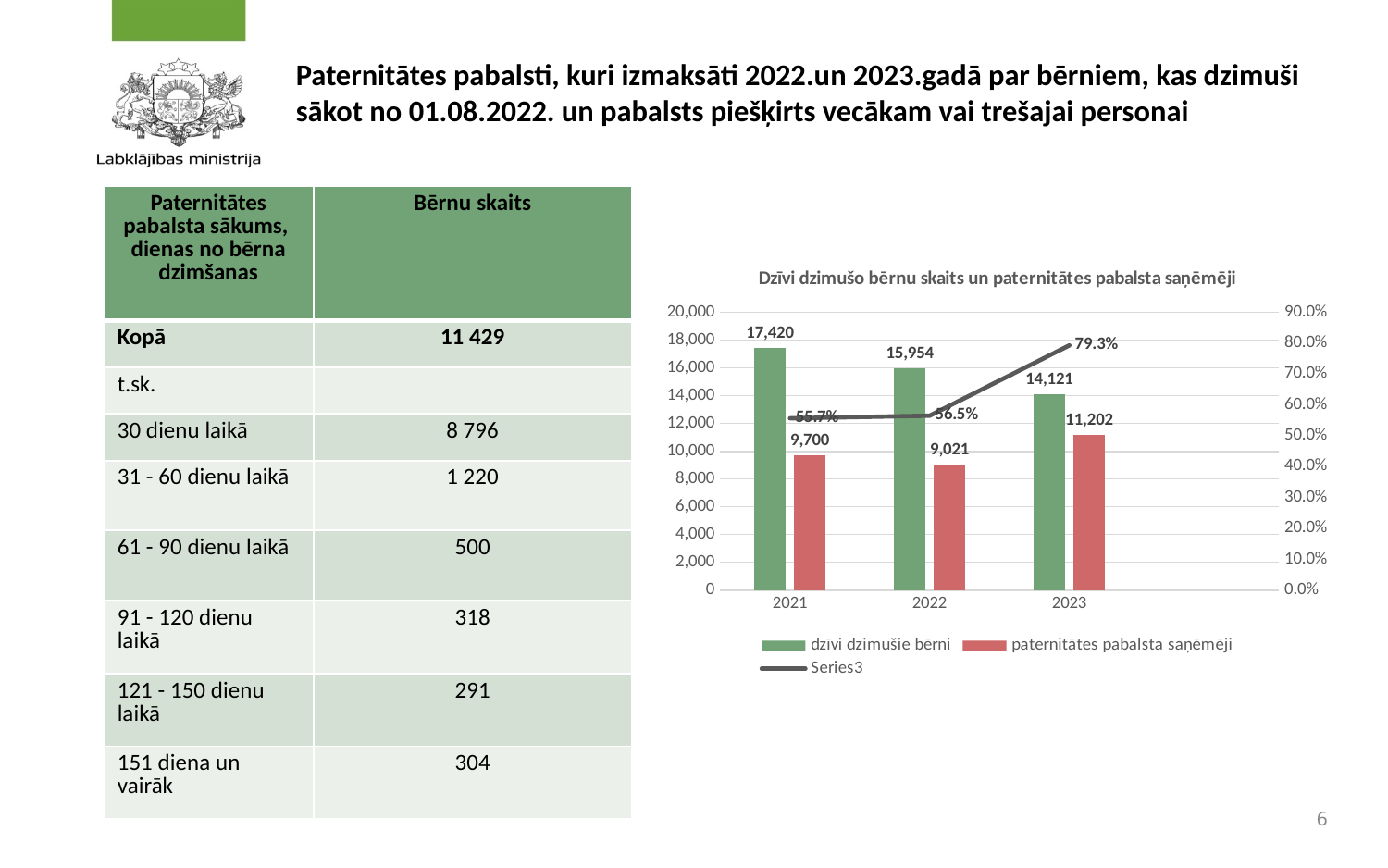
What is the value for dzīvi dzimušie bērni in 2021? 17,420 Does the value for dzīvi dzimušie bērni rise or fall from 2021 to 2023? fall What is the difference between dzīvi dzimušie bērni and paternitātes pabalsta saņēmēji in 2022? 6,933 What is the value for paternitātes pabalsta saņēmēji in 2023? 11,202 In which year is the value for dzīvi dzimušie bērni the lowest? 2023 Which is larger in 2021: dzīvi dzimušie bērni or paternitātes pabalsta saņēmēji? dzīvi dzimušie bērni In which year is the value for paternitātes pabalsta saņēmēji the highest? 2023 What type of chart is shown on the slide? Bar chart with a line How many years are shown on the x axis of the chart? 3 How many series does the chart legend list? 3 What is the title of the chart on the slide? Dzīvi dzimušo bērnu skaits un paternitātes pabalsta saņēmēji What is the Series3 value for 2023? 79.3%